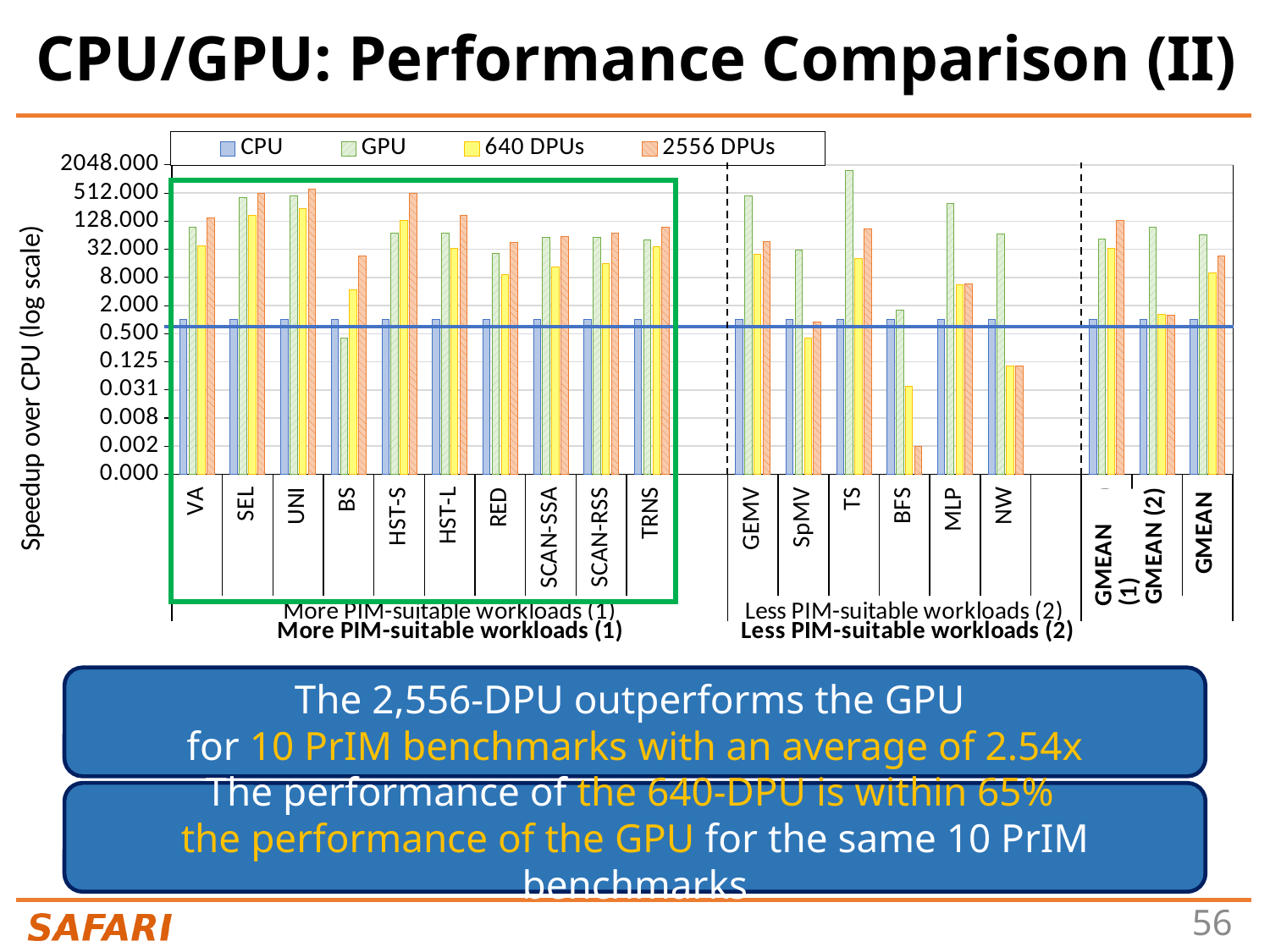
Is the GPU value for TS greater or less than 512.000? greater Which workload has the lowest 2556 DPUs bar in the chart? BFS What kind of chart is shown on the slide? bar chart What are the four series listed in the chart legend? CPU, GPU, 640 DPUs, 2556 DPUs Which workload has the highest GPU bar in the chart? TS For GEMV, which is larger: the GPU value or the 2556 DPUs value? GPU For BS, which is larger: the GPU value or the 2556 DPUs value? 2556 DPUs What is the label of the y axis of the chart? Speedup over CPU (log scale) How many workload categories are listed under the group 'More PIM-suitable workloads (1)'? 10 Is the 2556 DPUs value for BFS greater or less than 0.008? less How many series does the chart legend list? 4 How many workload categories are listed under the group 'Less PIM-suitable workloads (2)'? 6